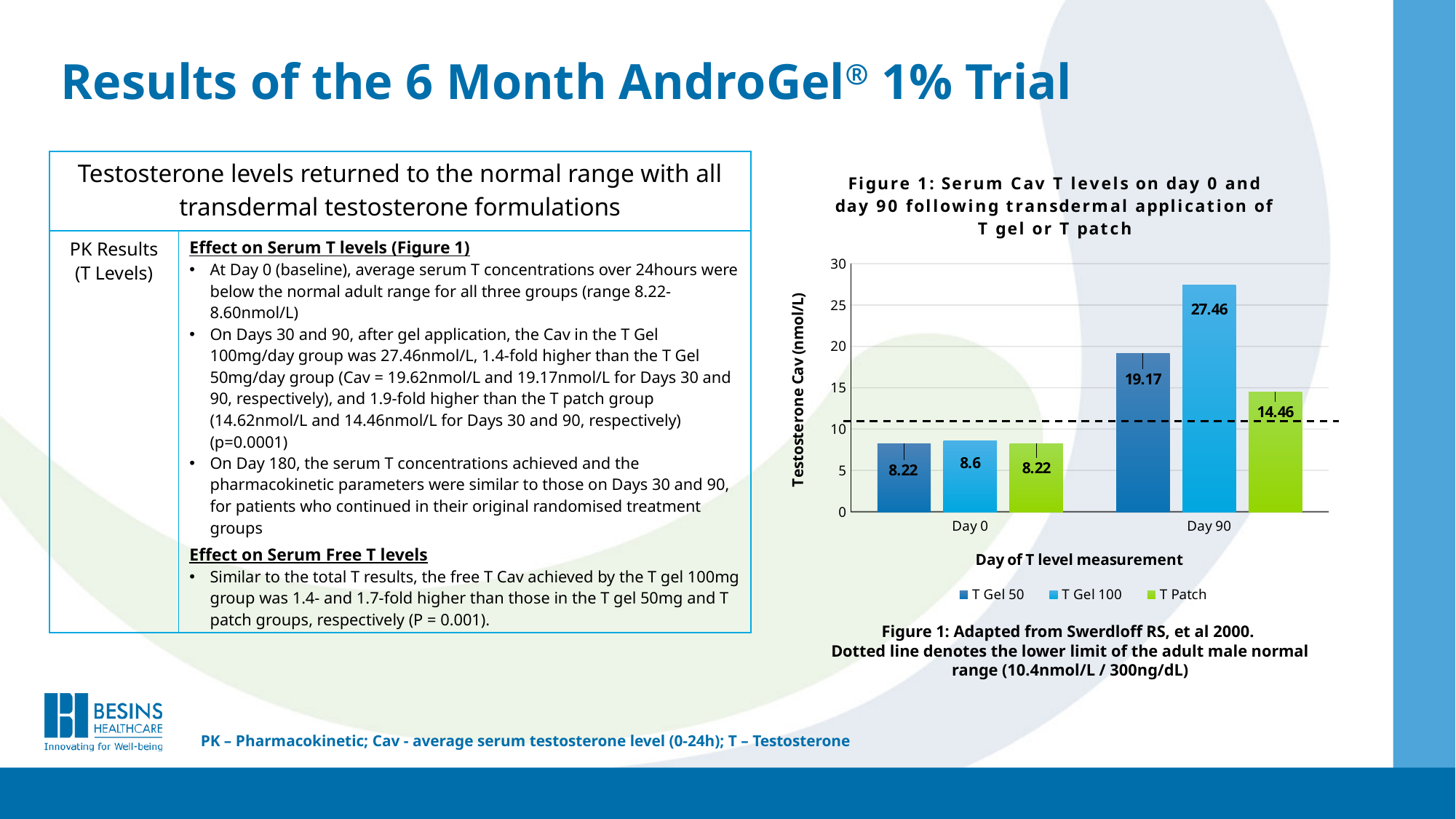
What is the Serum Cav T level for T Gel 100 on Day 0? 8.6 What is the Serum Cav T level for T Gel 100 on Day 90? 27.46 Which series has the lowest value on Day 90? T Patch What kind of chart is shown in Figure 1? Bar chart Which is larger on Day 90: the T Gel 50 value or the T Patch value? T Gel 50 What is the Serum Cav T level for T Gel 50 on Day 0? 8.22 How many series does the legend list? 3 What does the dotted line on the chart denote? The lower limit of the adult male normal range (10.4nmol/L / 300ng/dL) What is the Serum Cav T level for T Patch on Day 90? 14.46 Which series has the highest value on Day 90? T Gel 100 Is the value for T Gel 100 on Day 90 greater or less than 25? greater What is the difference between the T Gel 100 and T Gel 50 values on Day 90? 8.29